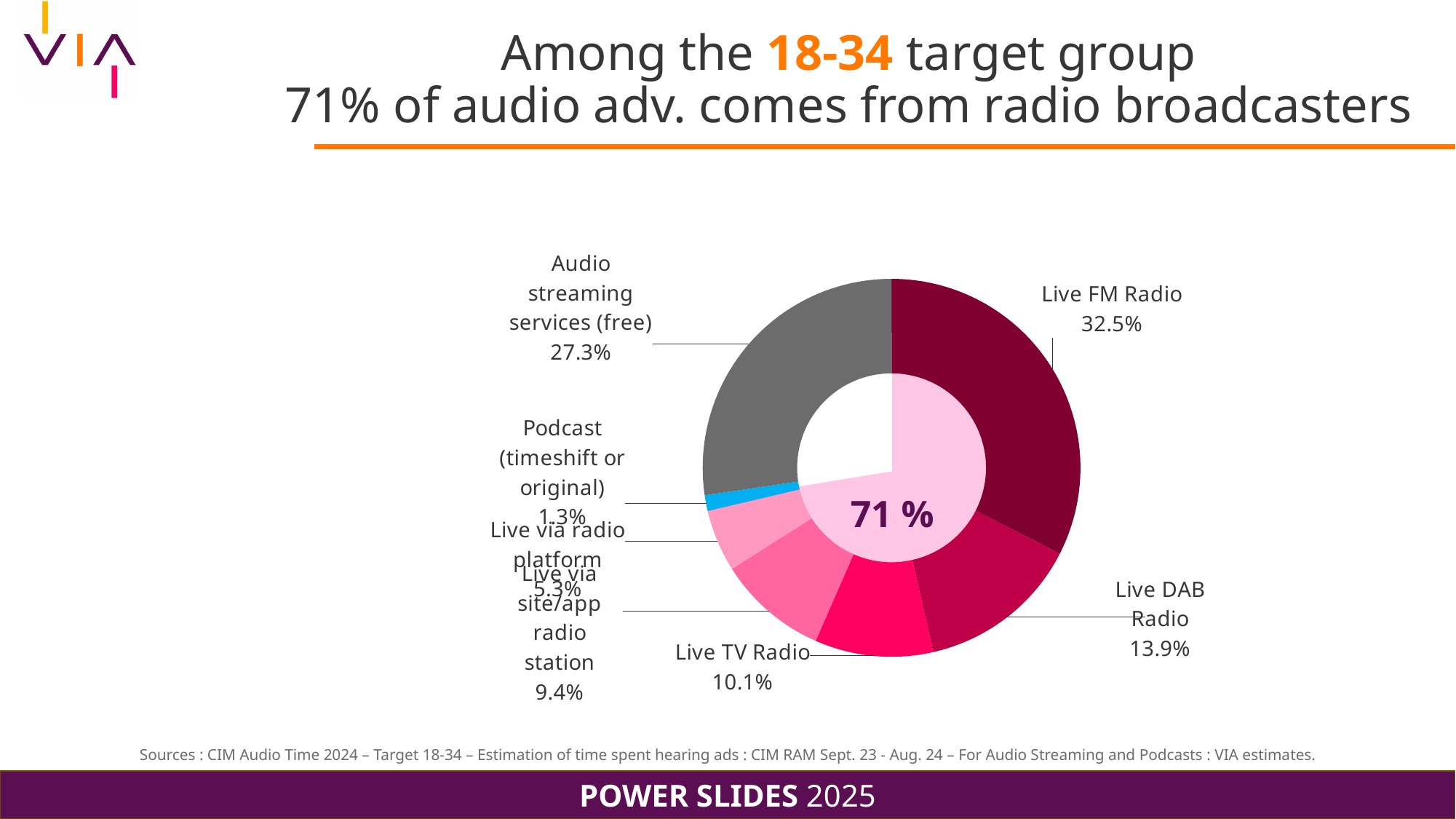
What is the value shown for Podcast (timeshift or original)? 1.3% Which is larger: the share of Live TV Radio or the share of Live via site/app radio station? Live TV Radio What kind of chart is shown on the slide? Pie chart (donut) What is the difference between the shares of Live FM Radio and Audio streaming services (free)? 5.2% What is the value shown for Live TV Radio? 10.1% What is the value shown for Audio streaming services (free)? 27.3% What percentage is printed in the centre of the chart? 71 % How many categories are shown in the chart? 7 Which category has the smallest share in the chart? Podcast (timeshift or original) What share does Live DAB Radio have in the chart? 13.9% Which category has the largest share in the chart? Live FM Radio What share of audio advertising comes from Live FM Radio? 32.5%